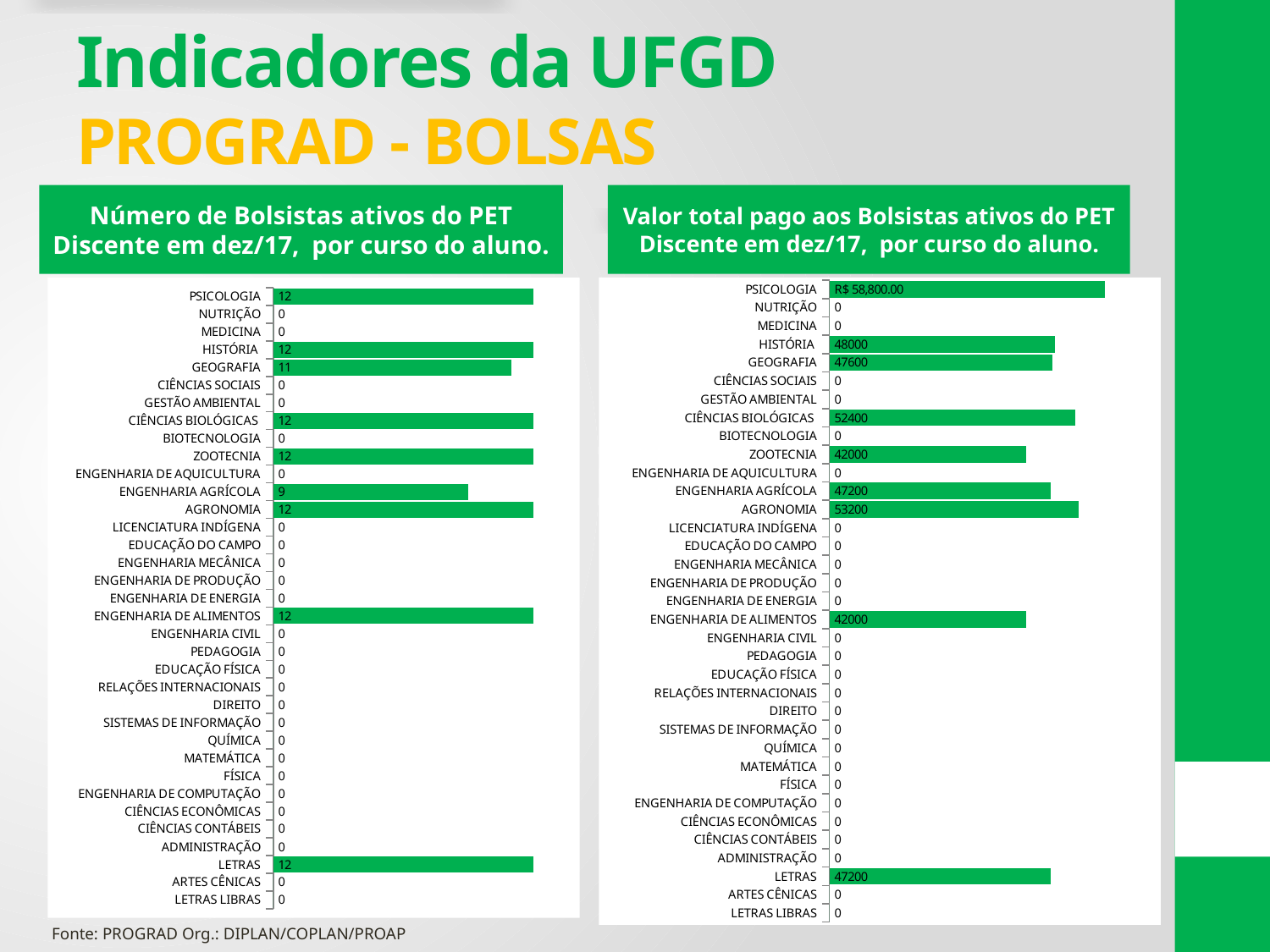
In the chart 'Número de Bolsistas ativos do PET Discente em dez/17, por curso do aluno', what is the difference between the values for AGRONOMIA and ENGENHARIA AGRÍCOLA? 3 In the chart 'Número de Bolsistas ativos do PET Discente em dez/17, por curso do aluno', which is larger, the value for HISTÓRIA or the value for GEOGRAFIA? HISTÓRIA In the chart 'Valor total pago aos Bolsistas ativos do PET Discente em dez/17, por curso do aluno', what is the value for ENGENHARIA DE ALIMENTOS? 42000 In the chart 'Valor total pago aos Bolsistas ativos do PET Discente em dez/17, por curso do aluno', what is the value for CIÊNCIAS BIOLÓGICAS? 52400 In the chart 'Valor total pago aos Bolsistas ativos do PET Discente em dez/17, por curso do aluno', which is larger, the value for ZOOTECNIA or the value for LETRAS? LETRAS How many courses are listed in the chart 'Valor total pago aos Bolsistas ativos do PET Discente em dez/17, por curso do aluno'? 35 What type of chart is the chart 'Número de Bolsistas ativos do PET Discente em dez/17, por curso do aluno'? Bar chart In the chart 'Valor total pago aos Bolsistas ativos do PET Discente em dez/17, por curso do aluno', what is the value for PSICOLOGIA? R$ 58,800.00 In the chart 'Valor total pago aos Bolsistas ativos do PET Discente em dez/17, por curso do aluno', what is the difference between the values for AGRONOMIA and CIÊNCIAS BIOLÓGICAS? 800 In the chart 'Valor total pago aos Bolsistas ativos do PET Discente em dez/17, por curso do aluno', which course has the highest value? PSICOLOGIA In the chart 'Número de Bolsistas ativos do PET Discente em dez/17, por curso do aluno', how many active scholarship holders are in GEOGRAFIA? 11 In the chart 'Número de Bolsistas ativos do PET Discente em dez/17, por curso do aluno', what is the value for ENGENHARIA AGRÍCOLA? 9